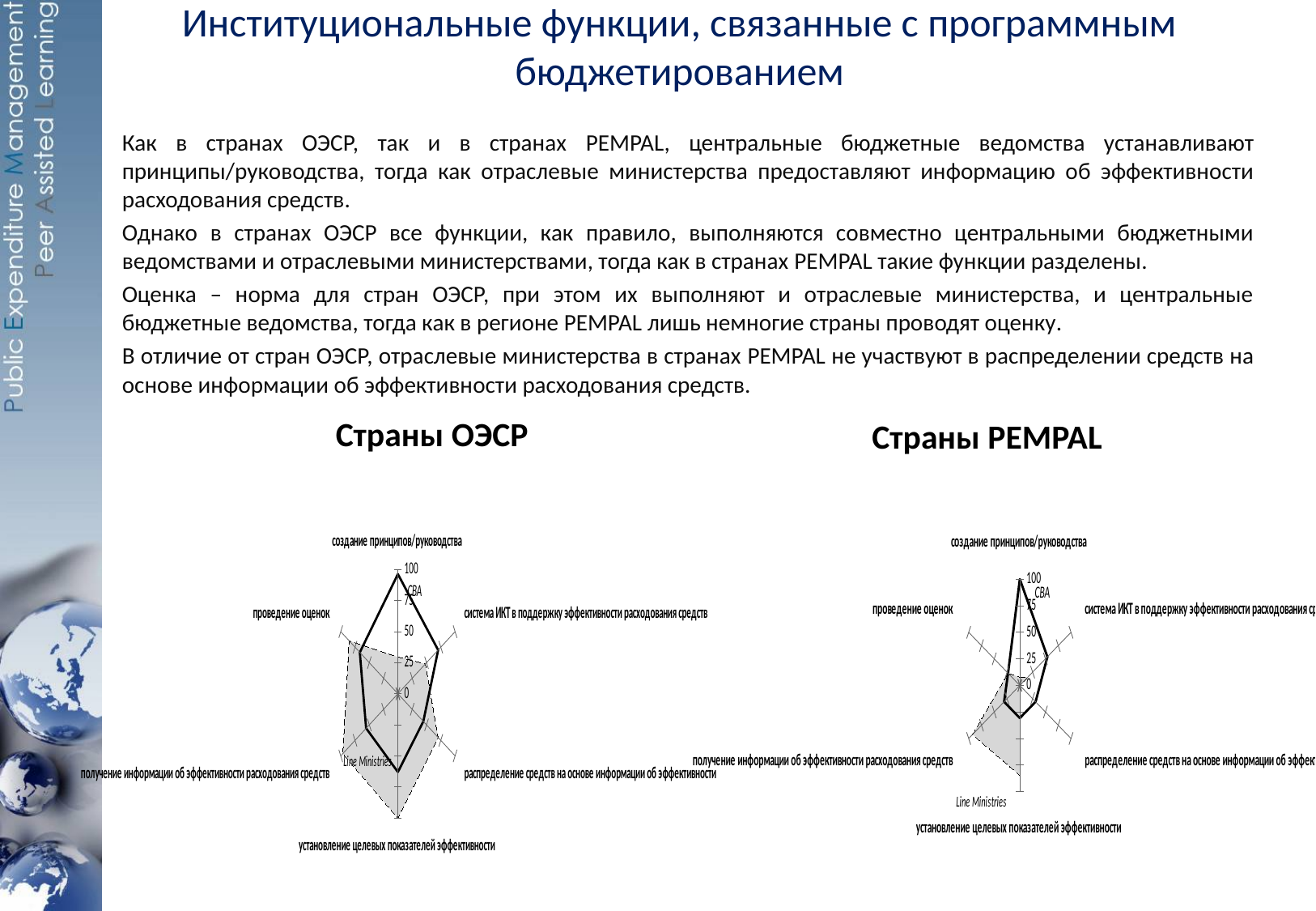
How many categories (axes) does the 'Страны PEMPAL' radar chart have? 6 In the 'Страны PEMPAL' chart, is the Line Ministries value for 'установление целевых показателей эффективности' greater or less than 75? greater How many series are plotted on the 'Страны ОЭСР' chart? 2 What kind of chart is used for the 'Страны ОЭСР' chart? Radar chart In the 'Страны ОЭСР' chart, is the CBA value for 'создание принципов/руководства' greater or less than 75? greater In the 'Страны PEMPAL' chart, is the CBA value for 'создание принципов/руководства' greater or less than 75? greater In the 'Страны ОЭСР' chart, which series has the higher value for 'создание принципов/руководства', CBA or Line Ministries? CBA In the 'Страны PEMPAL' chart, which series has the higher value for 'установление целевых показателей эффективности', CBA or Line Ministries? Line Ministries What are the two series shown on the 'Страны PEMPAL' chart? CBA and Line Ministries What is the maximum value shown on the axis scale of the 'Страны ОЭСР' radar chart? 100